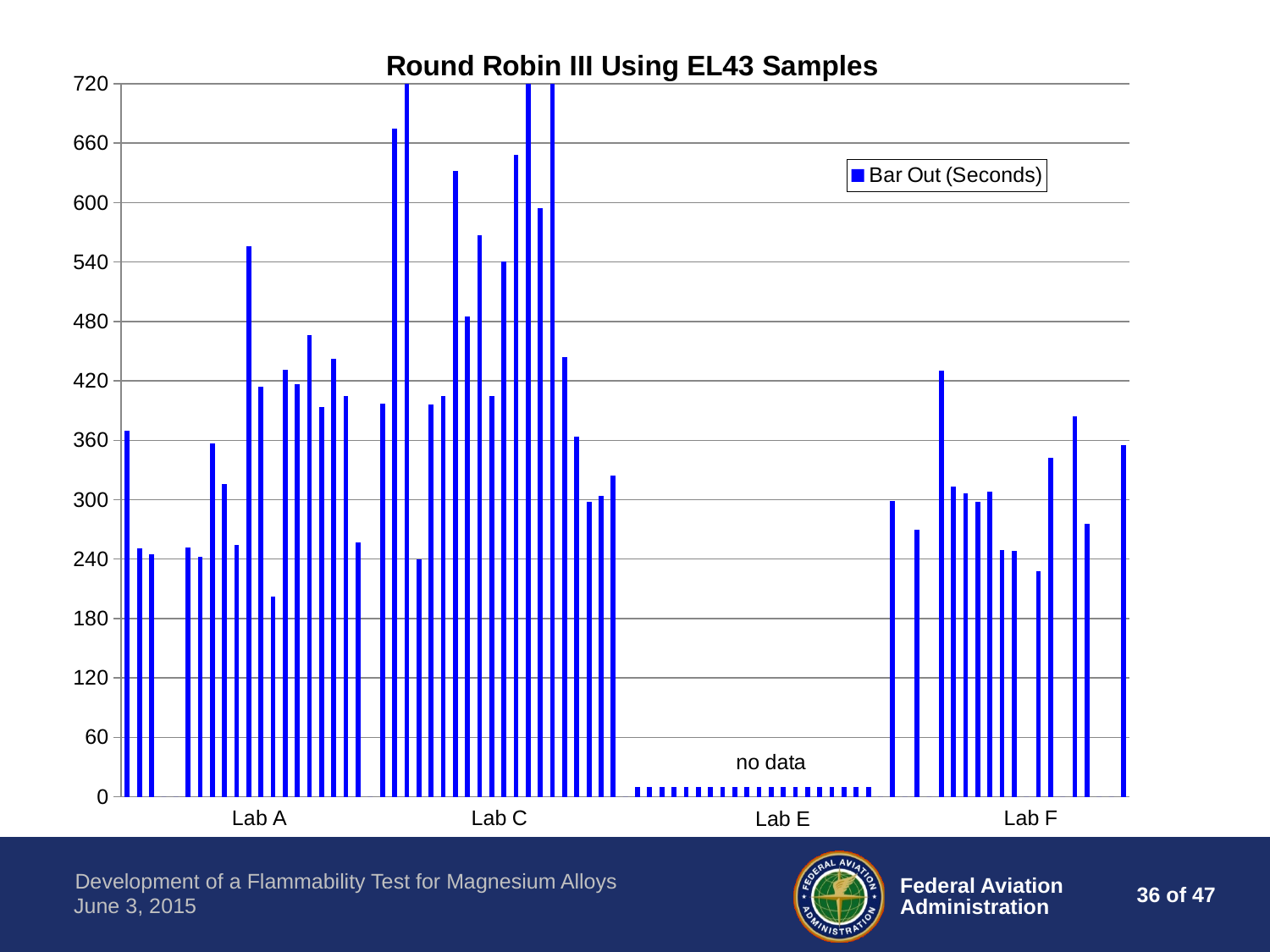
Which lab group is marked as having no data? Lab E Is the tallest bar in Lab F greater or less than 480? less What is the title of the chart? Round Robin III Using EL43 Samples What kind of chart is shown on the slide? bar chart How many lab groups are labeled on the x axis? 4 Is the shortest bar in Lab A greater or less than 240? less What series name is shown in the legend? Bar Out (Seconds) What is the maximum value shown on the y axis? 720 Is the tallest bar in Lab A greater or less than 480? greater How many series does the legend list? 1 Which lab group contains the tallest bars in the chart? Lab C